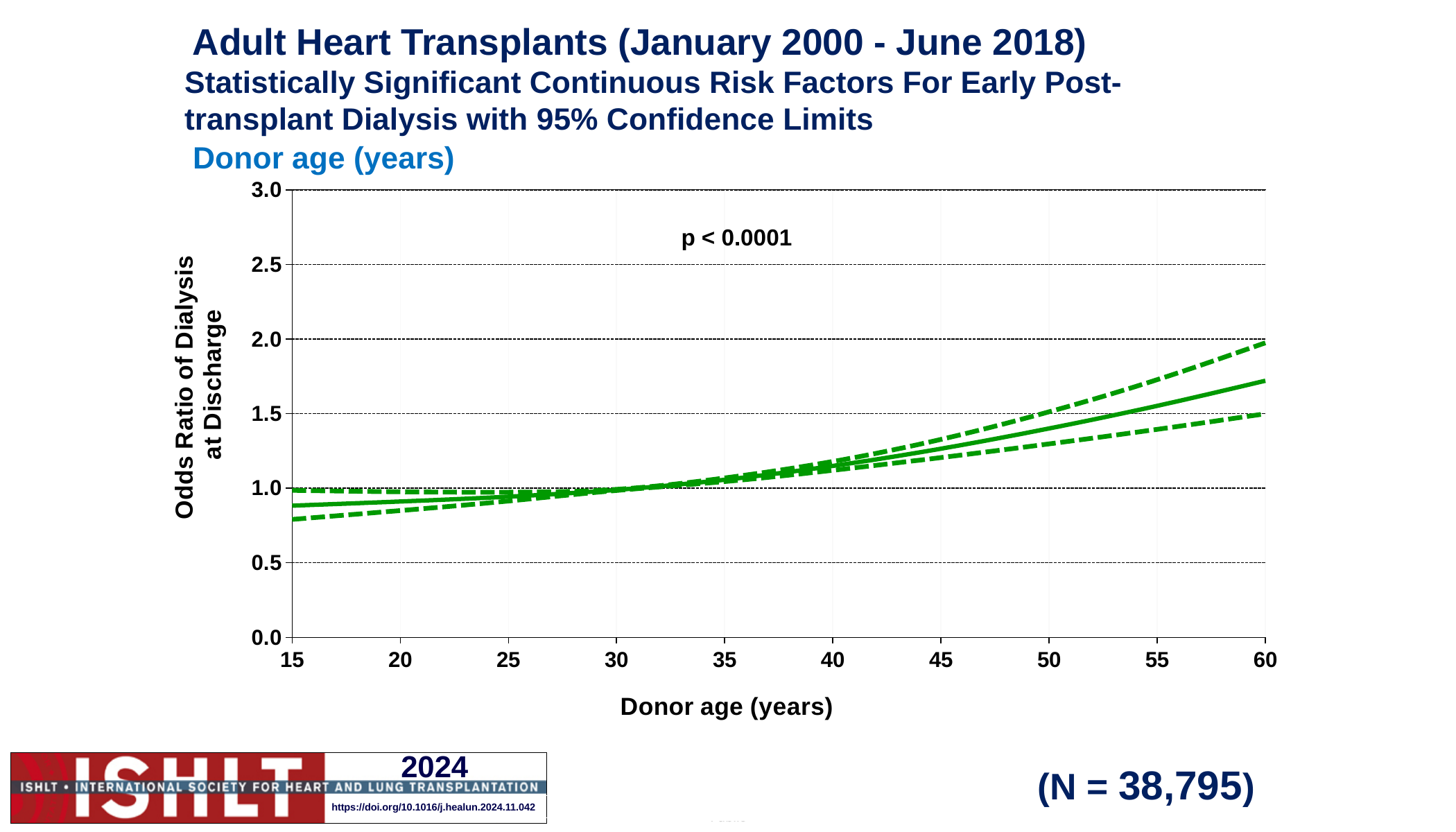
Is the odds ratio (solid line) at a donor age of 50 years greater or less than 1.5? less Is the odds ratio at a donor age of 60 years larger or smaller than at a donor age of 30 years? Larger What p-value is printed on the chart? p < 0.0001 Does the odds ratio of dialysis at discharge rise or fall as donor age increases from 15 to 60 years? Rise Is the upper 95% confidence limit at a donor age of 60 years greater or less than 1.5? greater Is the lower 95% confidence limit at a donor age of 15 years greater or less than 1.0? less What kind of chart is shown on the slide? Line chart What is the label of the y axis? Odds Ratio of Dialysis at Discharge